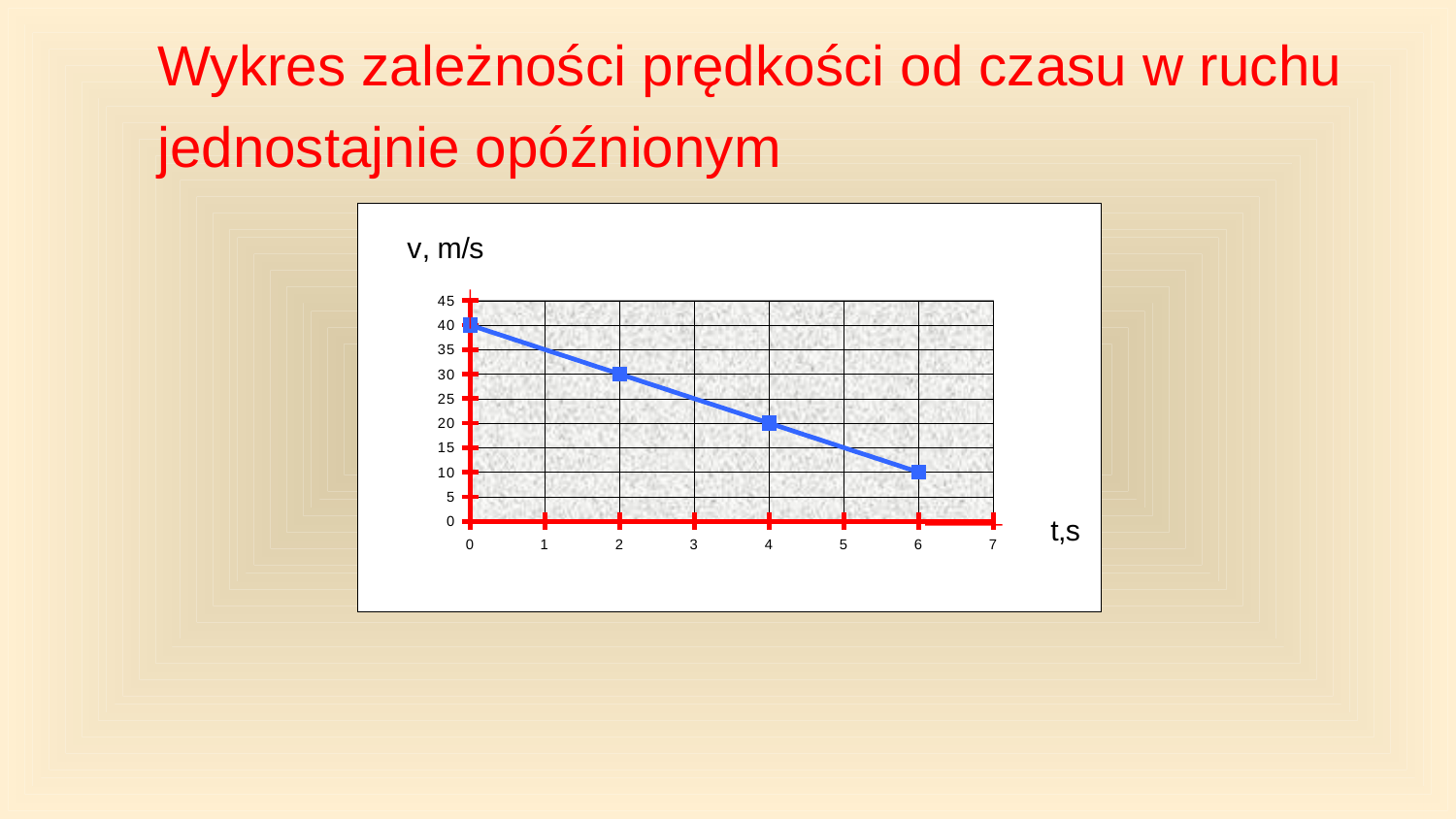
What kind of chart is shown on the slide? line chart What is the velocity v at t = 4 s? 20 How many data points are plotted on the chart? 4 What label is shown on the vertical axis of the chart? v, m/s Which is larger, the velocity at t = 2 s or at t = 4 s? t = 2 s Do the velocity values rise or fall as time increases along the x axis? fall What is the velocity v at t = 2 s? 30 At which time t is the velocity lowest? 6 What is the velocity v at t = 0 s? 40 What is the difference between the velocity at t = 0 s and at t = 6 s? 30 What is the velocity v at t = 6 s? 10 At which time t is the velocity highest? 0